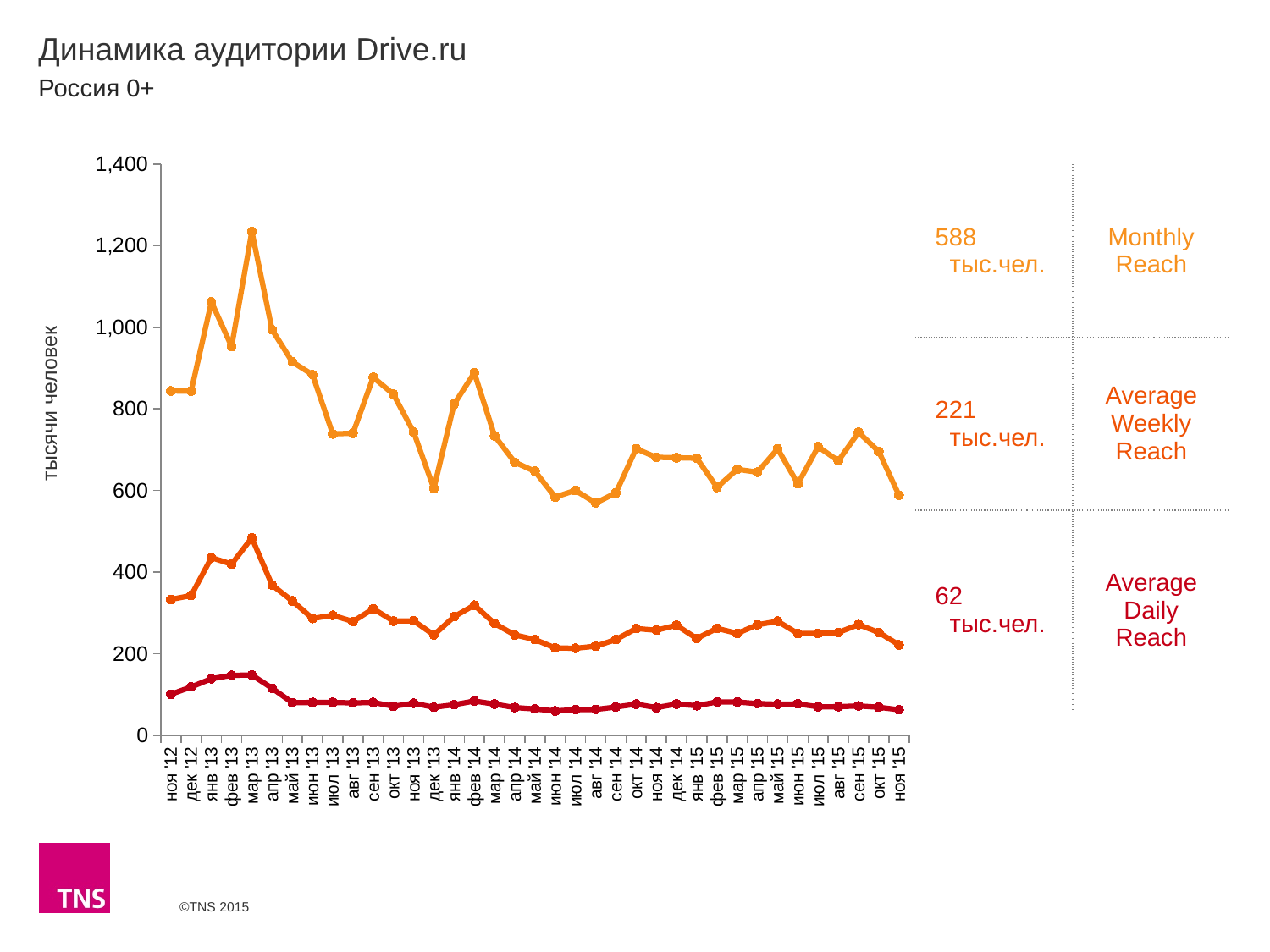
What Average Daily Reach value is printed on the slide? 62 тыс.чел. What is the label on the vertical axis of the chart? тысячи человек What Monthly Reach value is printed on the slide? 588 тыс.чел. How many series are plotted on the chart? 3 What Average Weekly Reach value is printed on the slide? 221 тыс.чел. Is the Average Weekly Reach value for мар '13 greater or less than 400? greater What is the difference between the printed Monthly Reach and Average Weekly Reach values? 367 тыс.чел. Does the Monthly Reach line rise or fall overall from мар '13 to дек '13? fall In which month does the Monthly Reach line reach its highest point? мар '13 What kind of chart is shown on the slide? line chart Is the Monthly Reach value for мар '13 greater or less than 1,200? greater Which month has the higher Monthly Reach, янв '13 or дек '13? янв '13